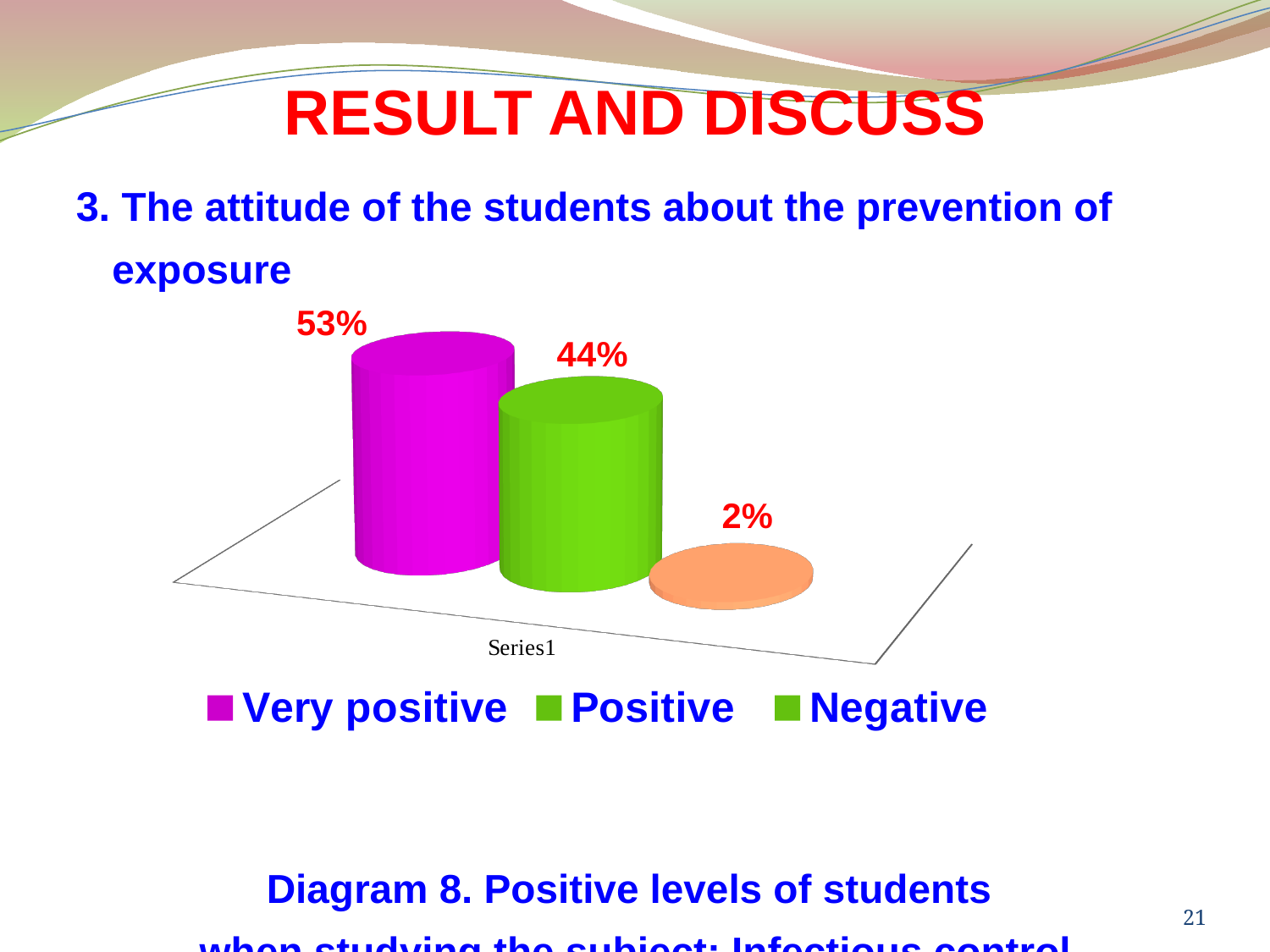
What is the value for Negative? 2% How many series does the legend list? 3 What is the value for Positive? 44% What kind of chart is shown on the slide? Bar chart Which is larger, the value for Positive or the value for Negative? Positive Which attitude level has the lowest value? Negative What is the total of the three values shown on the chart? 99% Which attitude level has the highest value? Very positive What is the difference between the Very positive and Positive values? 9% What label appears on the category axis below the bars? Series1 What is the value for Very positive? 53% What is the difference between the Positive and Negative values? 42%